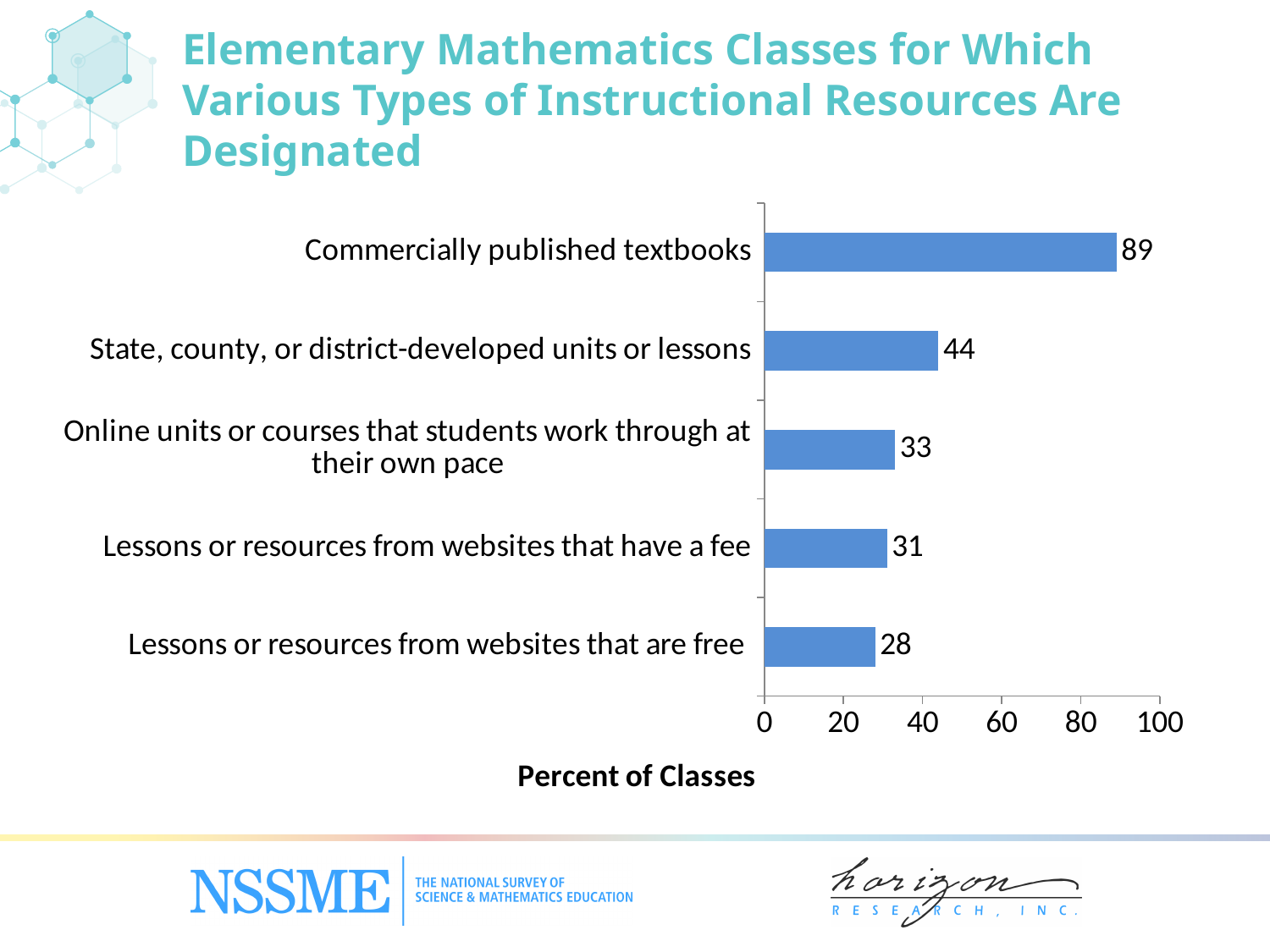
What is the difference between the values for commercially published textbooks and state, county, or district-developed units or lessons? 45 What is the label of the horizontal axis? Percent of Classes Which category has the lowest percent of classes? Lessons or resources from websites that are free Which is larger: the value for online units or courses that students work through at their own pace, or the value for lessons or resources from websites that have a fee? Online units or courses that students work through at their own pace What is the value for 'State, county, or district-developed units or lessons'? 44 What is the difference between the values for websites that have a fee and websites that are free? 3 What kind of chart is shown on the slide? Bar chart What is the value for 'Lessons or resources from websites that are free'? 28 What percent of classes designate commercially published textbooks? 89 Is the value for 'State, county, or district-developed units or lessons' greater or less than 40? greater How many categories are shown in the chart? 5 Which category has the highest percent of classes? Commercially published textbooks